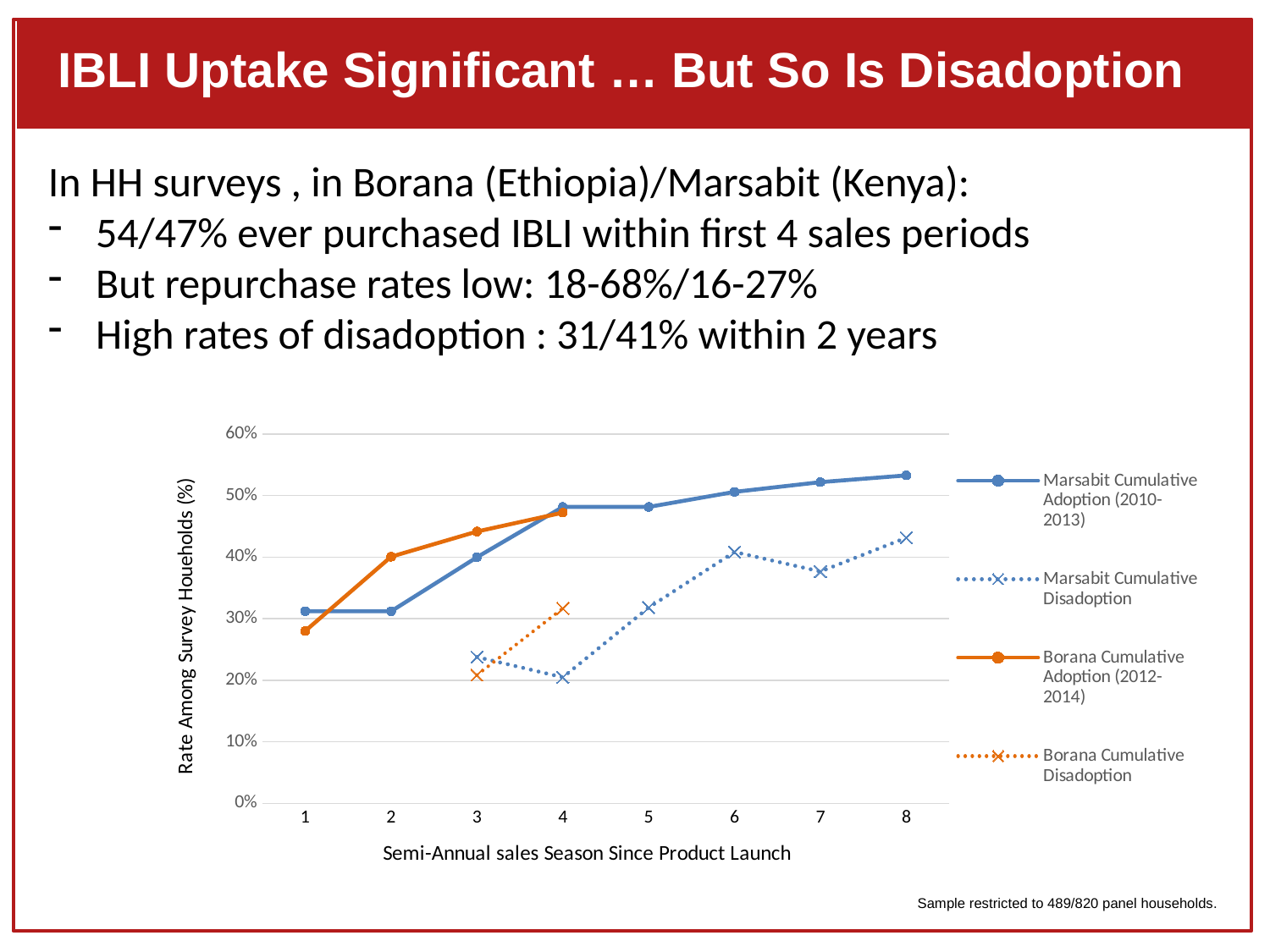
At season 2, which is higher: Borana Cumulative Adoption (2012-2014) or Marsabit Cumulative Adoption (2010-2013)? Borana Cumulative Adoption (2012-2014) Does the Marsabit Cumulative Adoption (2010-2013) series generally rise or fall across the sales seasons? Rise How many data points are plotted for the Borana Cumulative Adoption (2012-2014) series? 4 Is the value for Marsabit Cumulative Adoption (2010-2013) at season 8 greater or less than 50%? greater How many data points are plotted for the Marsabit Cumulative Adoption (2010-2013) series? 8 What kind of chart is shown on the slide? Line chart In which season is the Marsabit Cumulative Disadoption series at its lowest? 4 Is the value for Marsabit Cumulative Disadoption at season 6 greater or less than 30%? greater What is the title of the x axis? Semi-Annual sales Season Since Product Launch Is the value for Marsabit Cumulative Adoption (2010-2013) at season 1 greater or less than 40%? less How many series does the chart legend list? 4